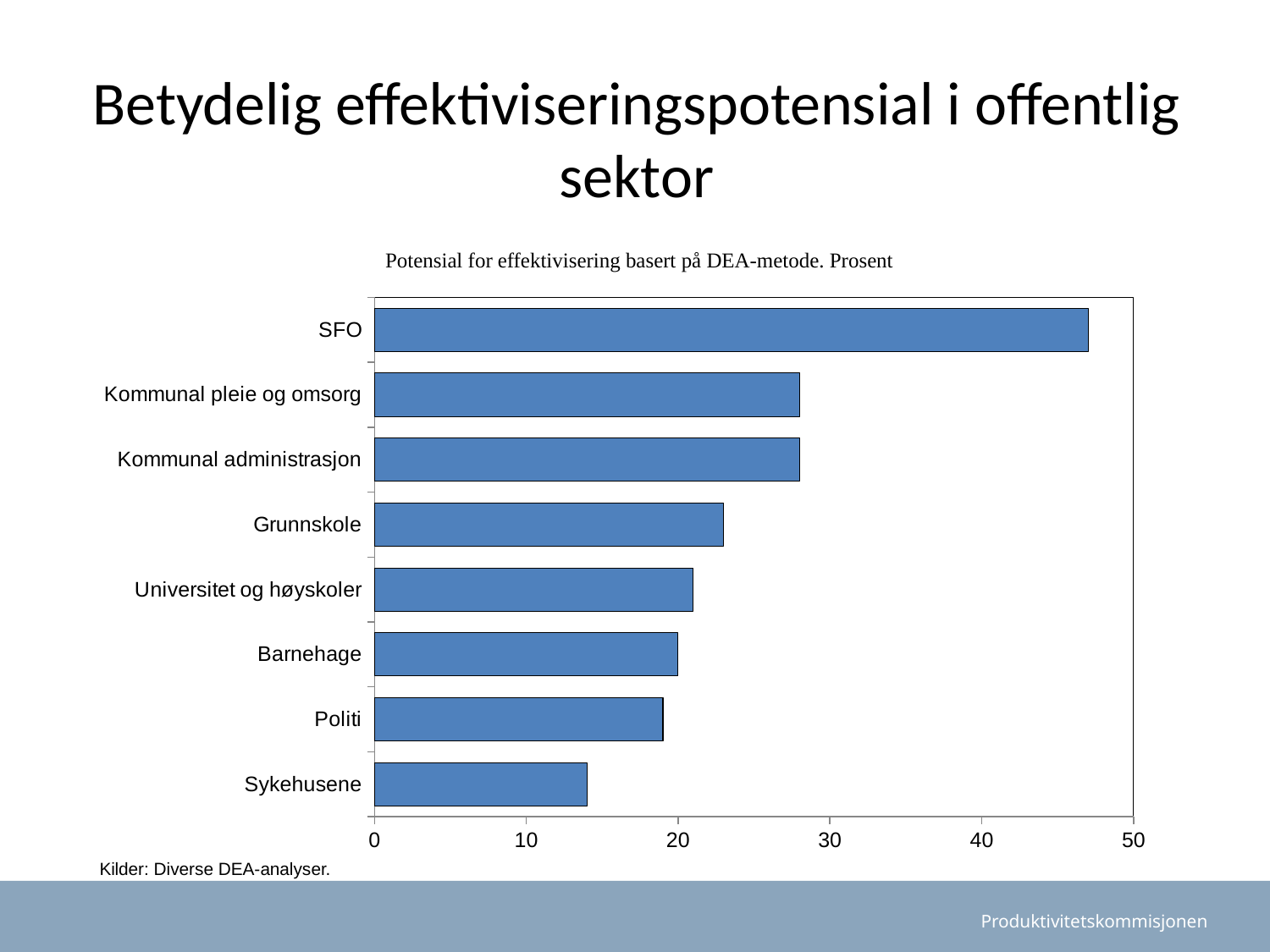
Which category has the lowest effektiviseringspotensial? Sykehusene Which is larger, the value for Grunnskole or the value for Politi? Grunnskole Is the value for SFO greater or less than 40? greater What is the subtitle printed above the chart? Potensial for effektivisering basert på DEA-metode. Prosent Is the value for Grunnskole greater or less than 20? greater Which is larger, the value for Sykehusene or the value for Kommunal pleie og omsorg? Kommunal pleie og omsorg Which category has the highest effektiviseringspotensial? SFO Is the value for Kommunal administrasjon greater or less than 30? less What kind of chart is shown on the slide? bar chart How many categories are shown in the chart? 8